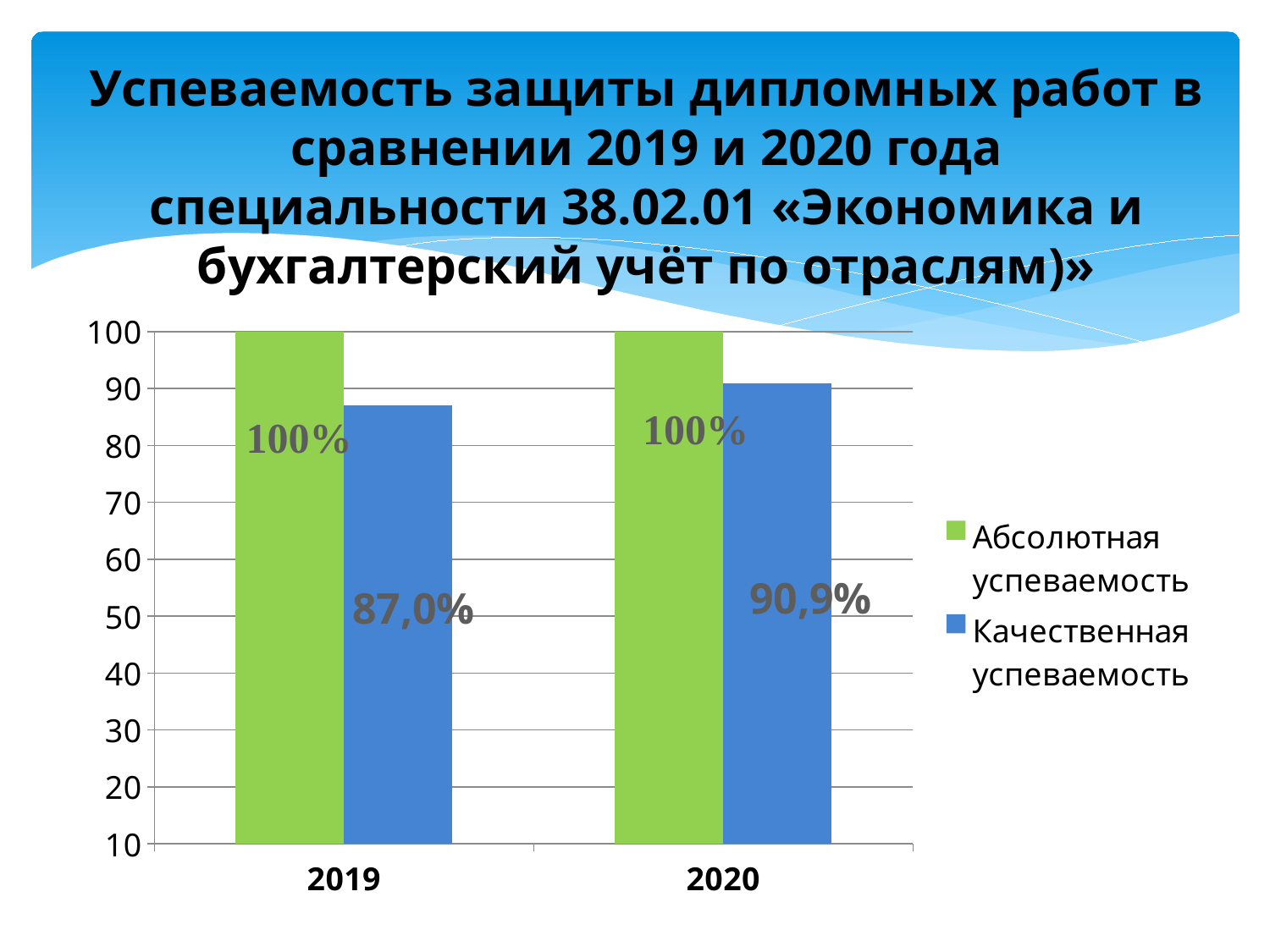
What type of chart is shown on the slide? bar chart In which year is Качественная успеваемость higher? 2020 What is the value of Абсолютная успеваемость for 2019? 100% How many series does the legend list? 2 Does Качественная успеваемость rise or fall from 2019 to 2020? rise Which is larger for 2019: Абсолютная успеваемость or Качественная успеваемость? Абсолютная успеваемость What is the value of Качественная успеваемость for 2019? 87,0% Is the value of Качественная успеваемость for 2019 greater or less than 90? less What is the value of Качественная успеваемость for 2020? 90,9% How many years (categories) are shown on the x axis? 2 What is the value of Абсолютная успеваемость for 2020? 100% In which year is Качественная успеваемость lowest? 2019